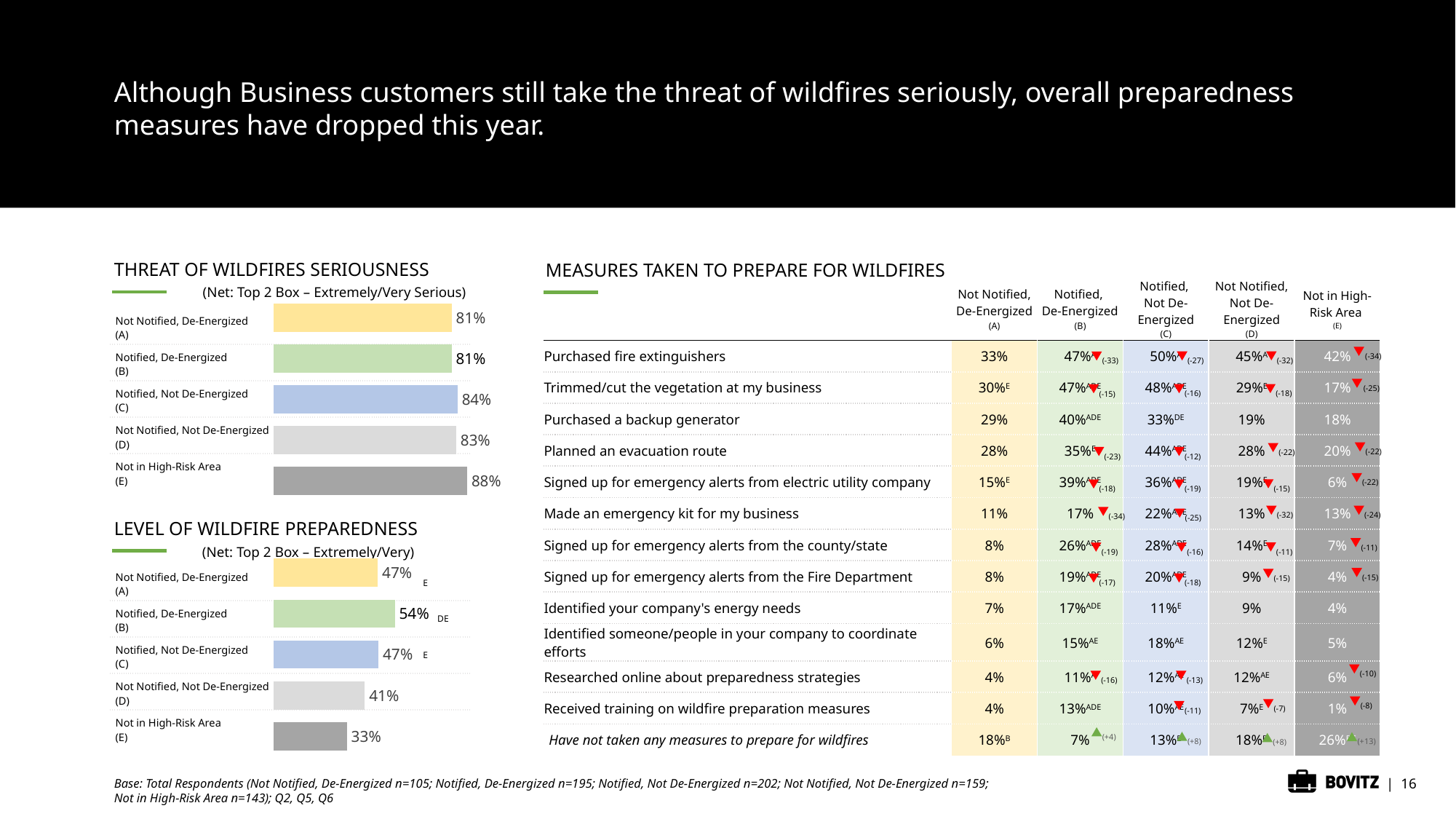
In the 'Level of Wildfire Preparedness' chart, which category has the lowest value? Not in High-Risk Area (E) In the 'Level of Wildfire Preparedness' chart, what is the difference between Notified, De-Energized (B) and Not in High-Risk Area (E)? 21 percentage points In the 'Threat of Wildfires Seriousness' chart, how many categories are shown? 5 In the 'Threat of Wildfires Seriousness' chart, what is the value for Notified, Not De-Energized (C)? 84% In the 'Level of Wildfire Preparedness' chart, is the value for Not Notified, De-Energized (A) larger or smaller than the value for Not Notified, Not De-Energized (D)? larger In the 'Threat of Wildfires Seriousness' chart, what is the difference between Not in High-Risk Area (E) and Not Notified, De-Energized (A)? 7 percentage points What type of chart is the 'Threat of Wildfires Seriousness' chart? Bar chart In the 'Level of Wildfire Preparedness' chart, what is the value for Not Notified, Not De-Energized (D)? 41% In the 'Level of Wildfire Preparedness' chart, which category has the highest value? Notified, De-Energized (B) In the 'Threat of Wildfires Seriousness' chart, what is the value for Not in High-Risk Area (E)? 88% In the 'Level of Wildfire Preparedness' chart, what is the value for Notified, De-Energized (B)? 54% In the 'Threat of Wildfires Seriousness' chart, which category has the highest value? Not in High-Risk Area (E)